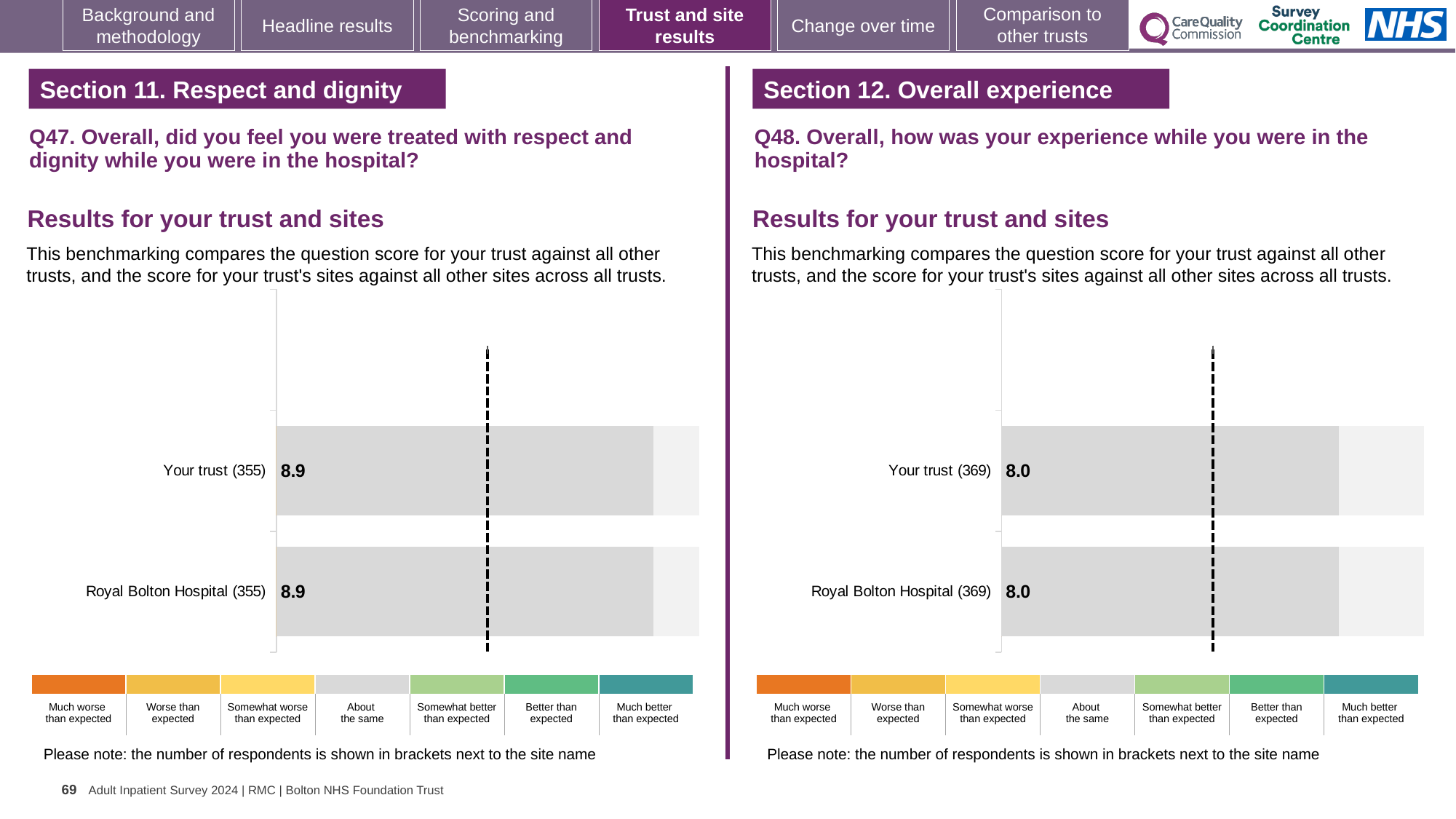
In the Q47 chart on the left, how many bars are plotted? 2 In the Q48 chart on the right, what is the difference between the score for Your trust and the score for Royal Bolton Hospital? 0.0 In the Q47 chart on the left, what is the difference between the score for Your trust and the score for Royal Bolton Hospital? 0.0 In the Q47 chart on the left, how many respondents are shown in brackets next to Royal Bolton Hospital? 355 In the Q48 chart on the right, what is the score for Your trust? 8.0 In the Q47 chart on the left, what is the score for Your trust? 8.9 In the Q47 chart on the left, what is the score for Royal Bolton Hospital? 8.9 In the Q48 chart on the right, how many bars are plotted? 2 What kind of chart is used for the Q47 results on the left? Bar chart In the Q48 chart on the right, how many respondents are shown in brackets next to Your trust? 369 In the Q48 chart on the right, what is the score for Royal Bolton Hospital? 8.0